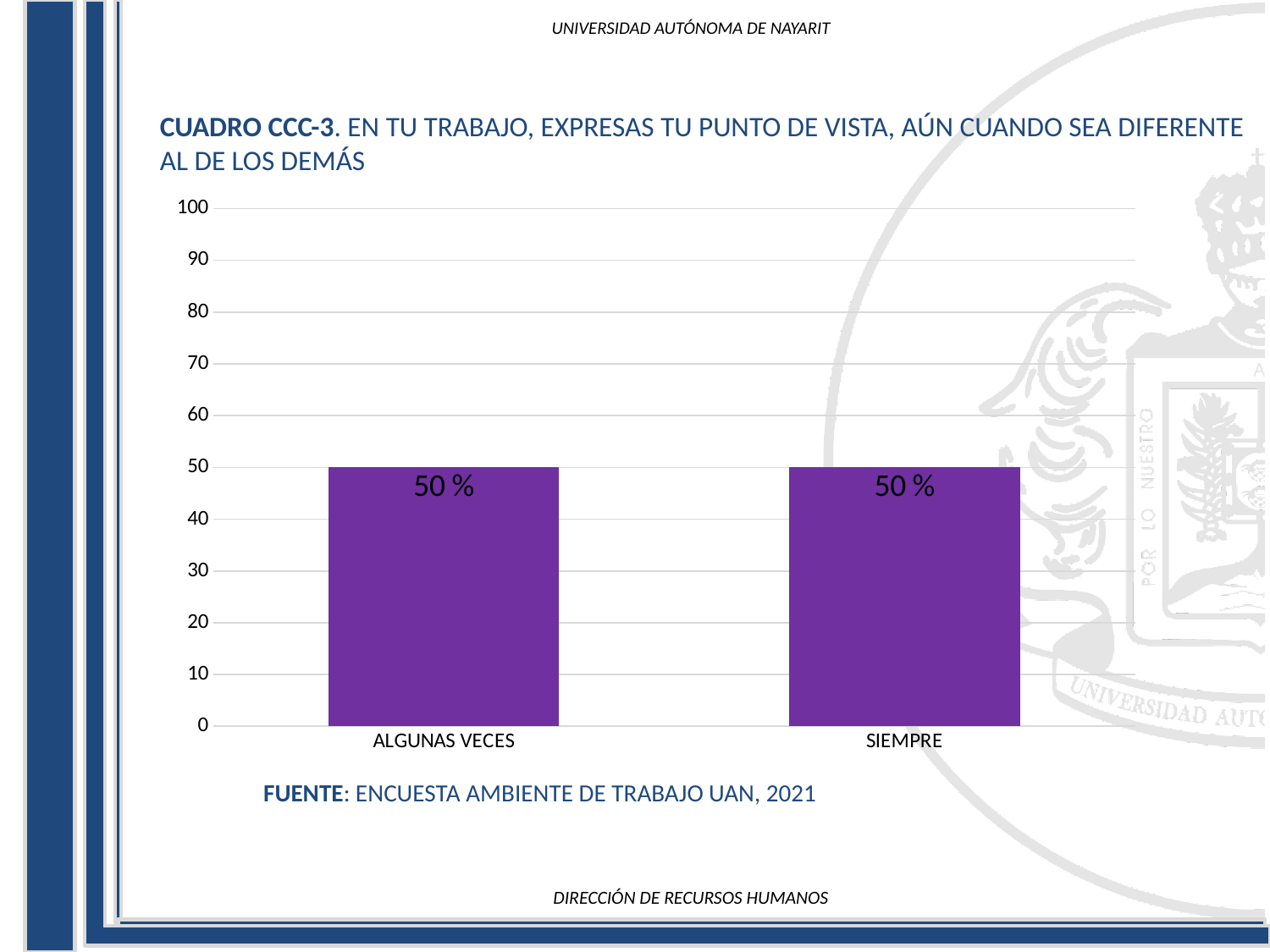
How many categories are shown on the x axis? 2 What is the maximum value shown on the y axis? 100 What is the total of the values for ALGUNAS VECES and SIEMPRE? 100 % Is the value for ALGUNAS VECES greater or less than 40? greater What is the difference between the values for ALGUNAS VECES and SIEMPRE? 0 What source is cited below the chart? ENCUESTA AMBIENTE DE TRABAJO UAN, 2021 What is the value for SIEMPRE? 50 % What kind of chart is shown on the slide? bar chart What is the value for ALGUNAS VECES? 50 % Is the value for SIEMPRE greater or less than 60? less